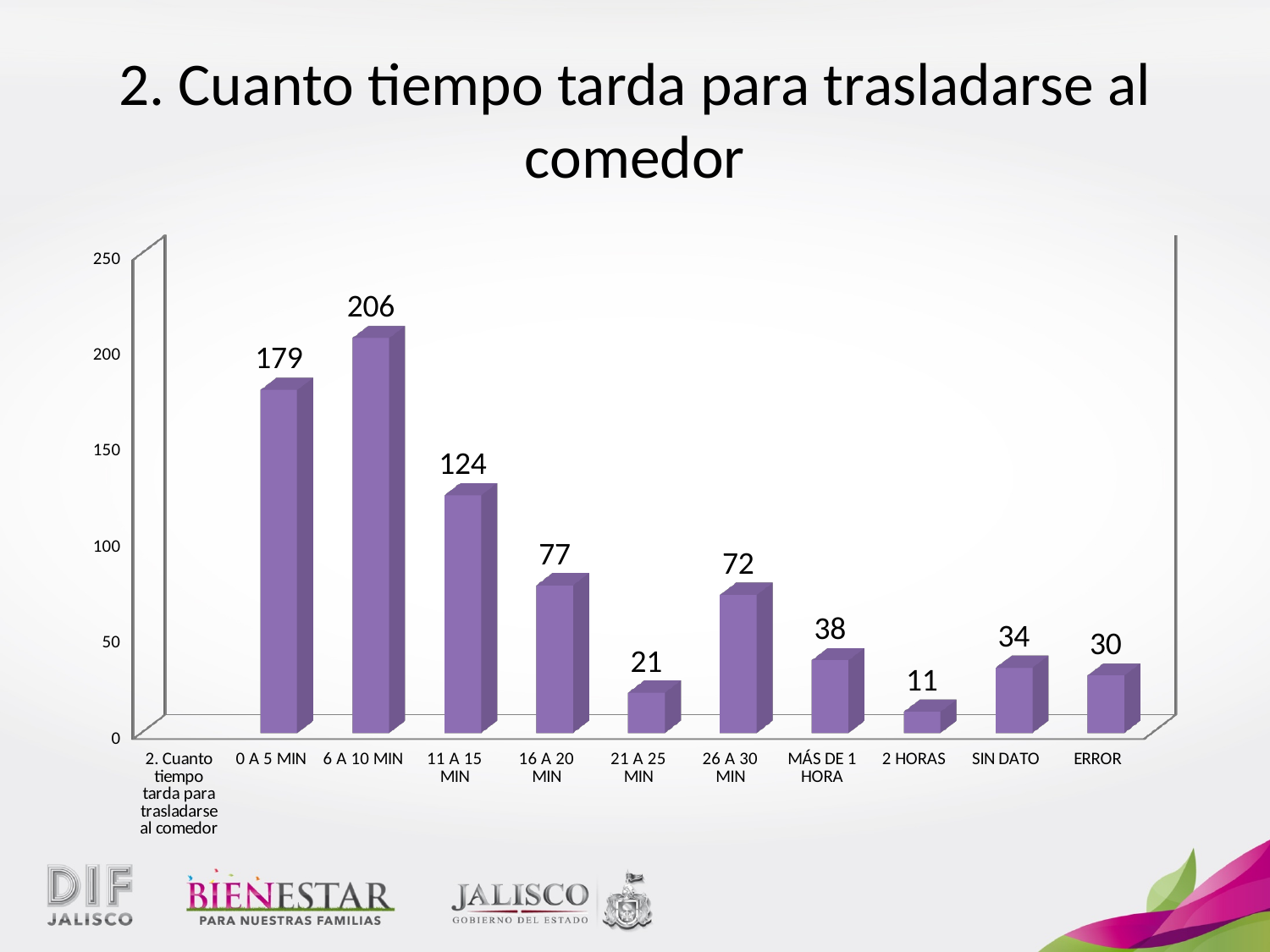
Which category has the highest value? 6 A 10 MIN What is the difference between the values for 6 A 10 MIN and 0 A 5 MIN? 27 How many bars are plotted in the chart? 10 Which is larger, the value for 16 A 20 MIN or the value for 26 A 30 MIN? 16 A 20 MIN What kind of chart is shown on the slide? Bar chart What is the value for the 6 A 10 MIN category? 206 What is the value for the 0 A 5 MIN category? 179 What is the title of the slide? 2. Cuanto tiempo tarda para trasladarse al comedor What is the value for the SIN DATO category? 34 What is the difference between the values for 11 A 15 MIN and 16 A 20 MIN? 47 What is the value for the 2 HORAS category? 11 Which category has the lowest value? 2 HORAS